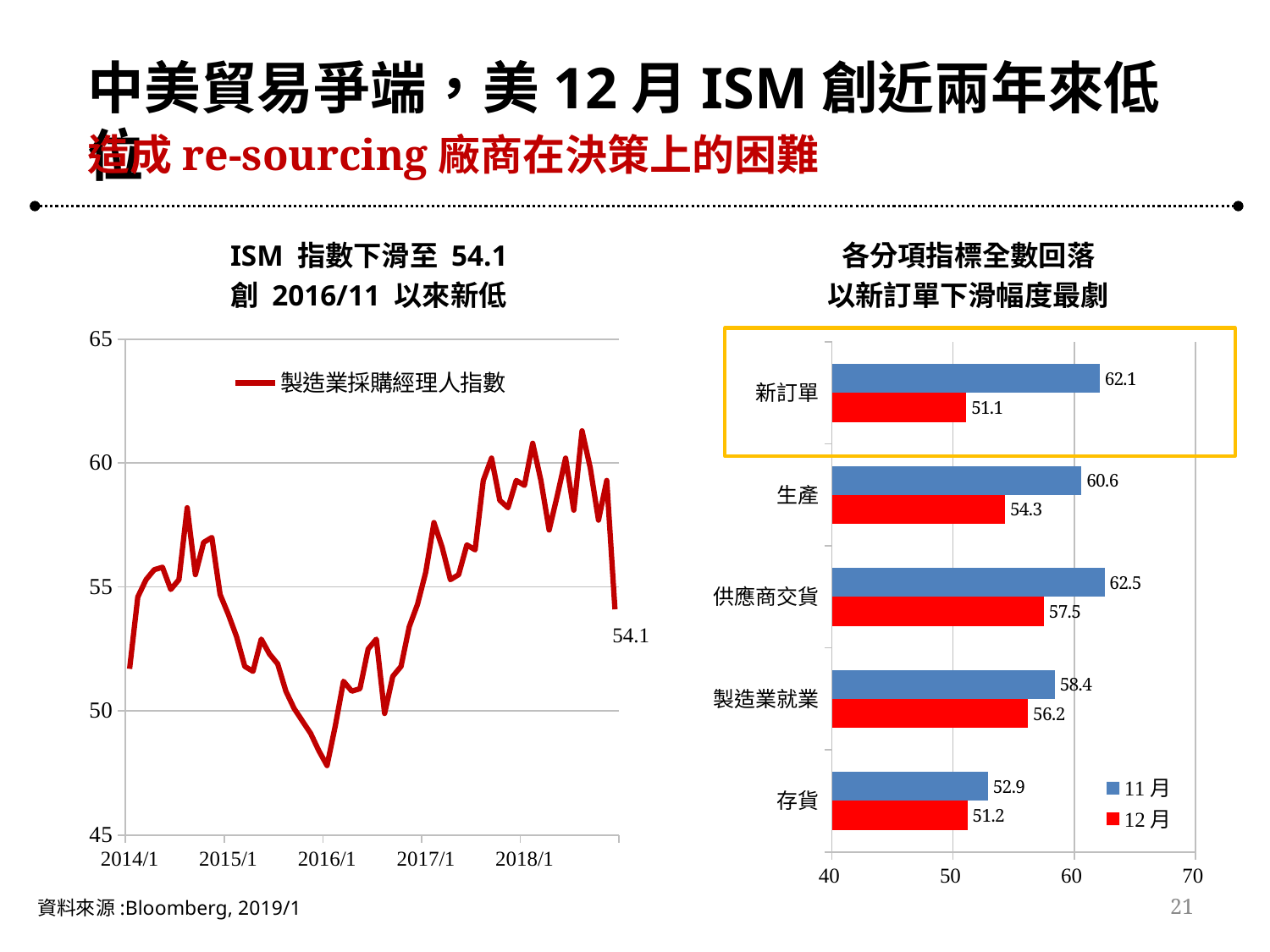
On the left chart (ISM 指數下滑至 54.1), is the value at 2016/1 greater or less than 50? less On the right chart (各分項指標全數回落), which category has the lowest 11 月 value? 存貨 On the left chart (ISM 指數下滑至 54.1), does the line generally rise or fall between 2016/1 and 2018/1? rise On the left chart (ISM 指數下滑至 54.1), what is the value of the last data point labelled on the line? 54.1 How many categories are shown on the right chart (各分項指標全數回落)? 5 What kind of chart is the right chart (各分項指標全數回落)? bar chart On the right chart (各分項指標全數回落), what is the difference between the 11 月 and 12 月 values for 新訂單? 11.0 What kind of chart is the left chart (ISM 指數下滑至 54.1)? line chart How many series does the legend of the right chart (各分項指標全數回落) list? 2 On the right chart (各分項指標全數回落), what is the 12 月 value for 新訂單? 51.1 On the left chart (ISM 指數下滑至 54.1), what series name does the legend show? 製造業採購經理人指數 On the right chart (各分項指標全數回落), which is larger: the 12 月 value for 供應商交貨 or the 12 月 value for 生產? 供應商交貨